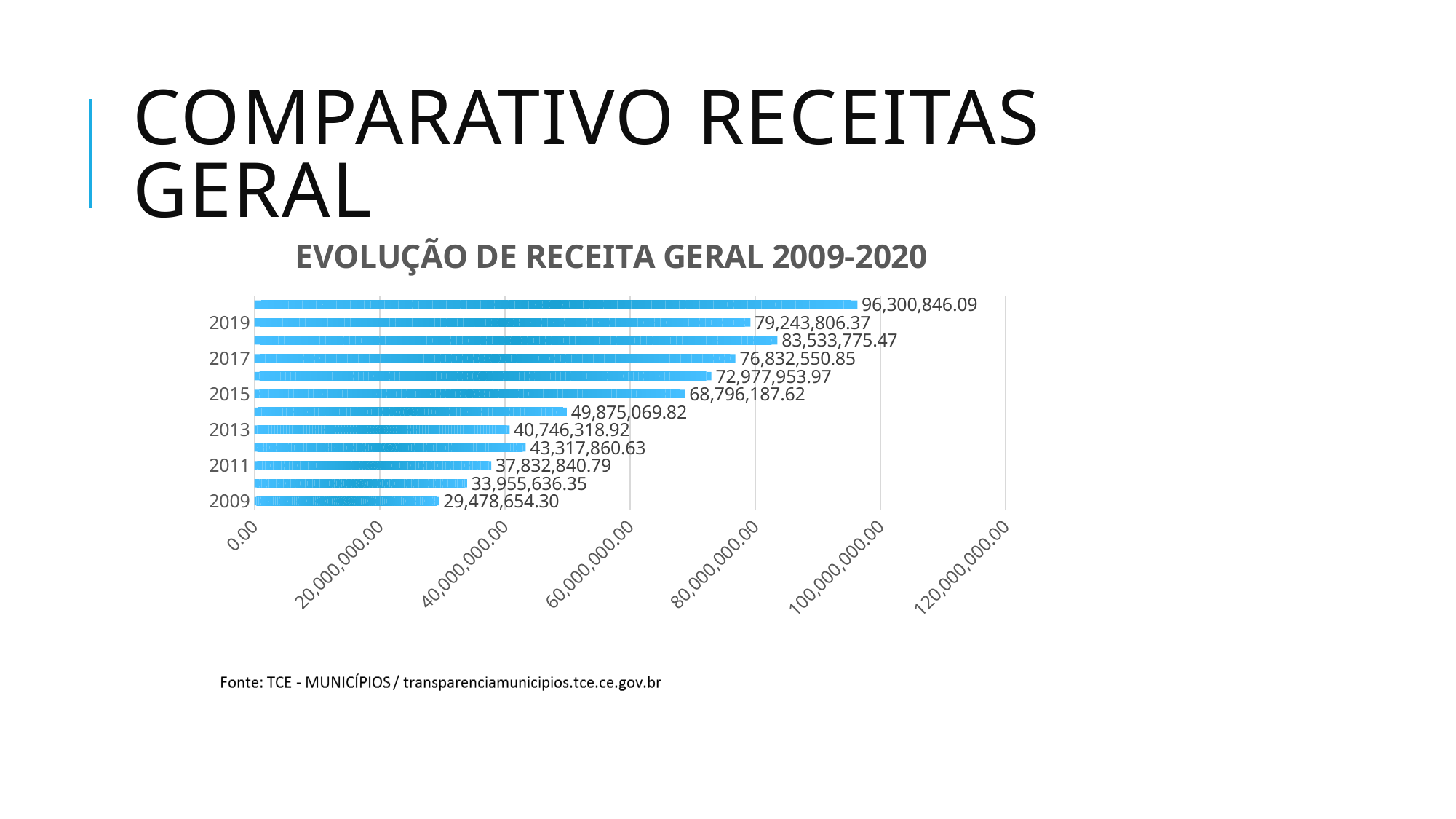
What is the value of the topmost bar (2020)? 96,300,846.09 What is the highest value shown in the chart? 96,300,846.09 How many bars are plotted in the chart? 12 What is the value for 2009? 29,478,654.30 What is the value for 2015? 68,796,187.62 What is the title of the chart? EVOLUÇÃO DE RECEITA GERAL 2009-2020 What is the value for 2013? 40,746,318.92 Which is larger, the value for 2017 or the value for 2015? 2017 Which year has the lowest value? 2009 What type of chart is shown on the slide? Bar chart What is the value for 2019? 79,243,806.37 What is the difference between the values for 2019 and 2017? 2,411,255.52